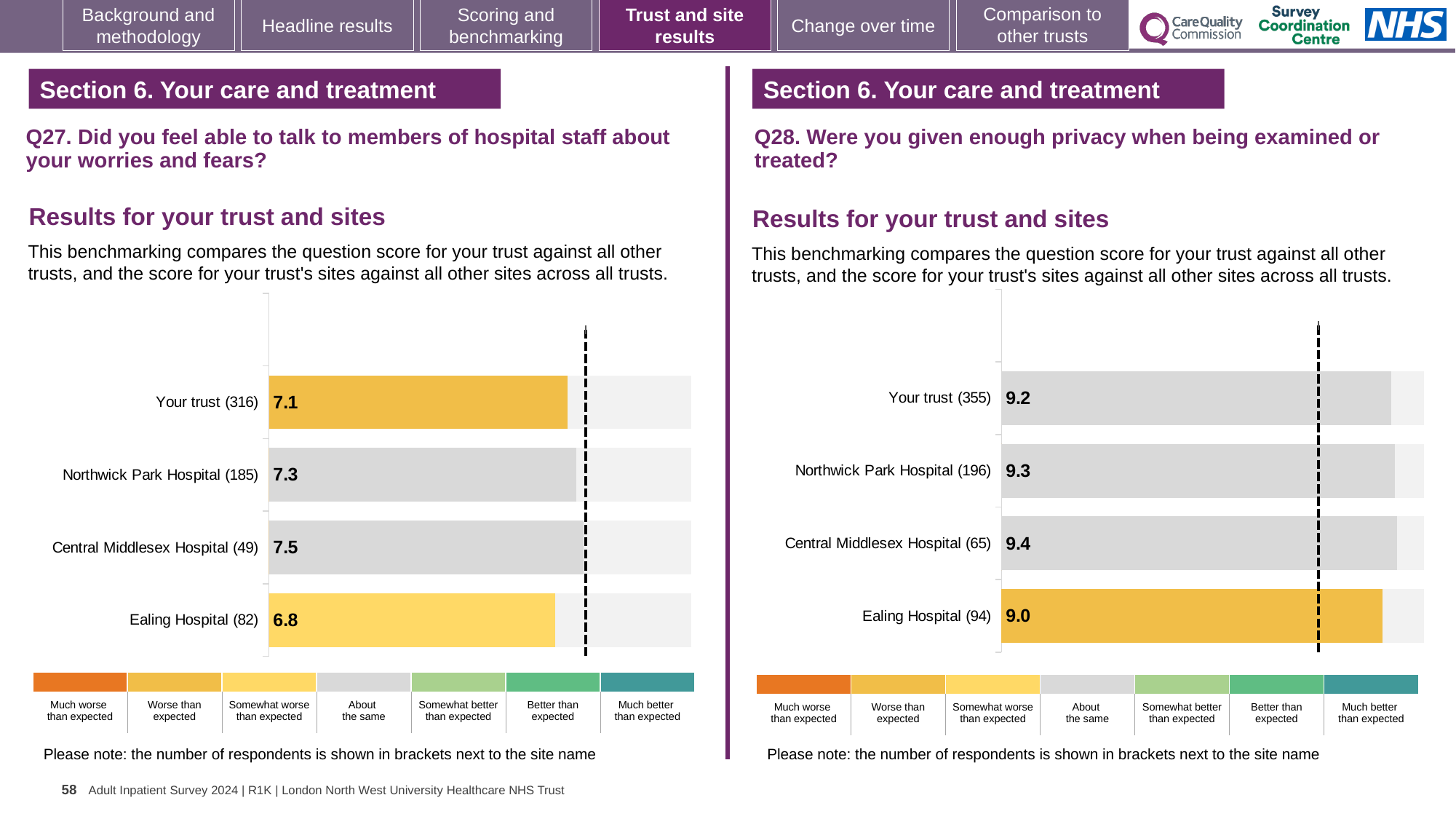
In the Q28 chart (right), what is the score for Central Middlesex Hospital? 9.4 In the Q27 chart (left), which site or trust has the highest score? Central Middlesex Hospital In the Q27 chart (left), what is the score for Your trust? 7.1 In the Q28 chart (right), which site or trust has the lowest score? Ealing Hospital In the Q27 chart (left), which site or trust has the lowest score? Ealing Hospital In the Q27 chart (left), how many bars are plotted? 4 In the Q27 chart (left), what is the difference between the scores for Northwick Park Hospital and Ealing Hospital? 0.5 What type of chart is used for the Q27 results on the left? Bar chart In the Q28 chart (right), is the score for Northwick Park Hospital or Ealing Hospital larger? Northwick Park Hospital In the Q28 chart (right), what is the difference between the scores for Central Middlesex Hospital and Your trust? 0.2 In the Q27 chart (left), what is the score for Ealing Hospital? 6.8 In the Q28 chart (right), what is the score for Your trust? 9.2